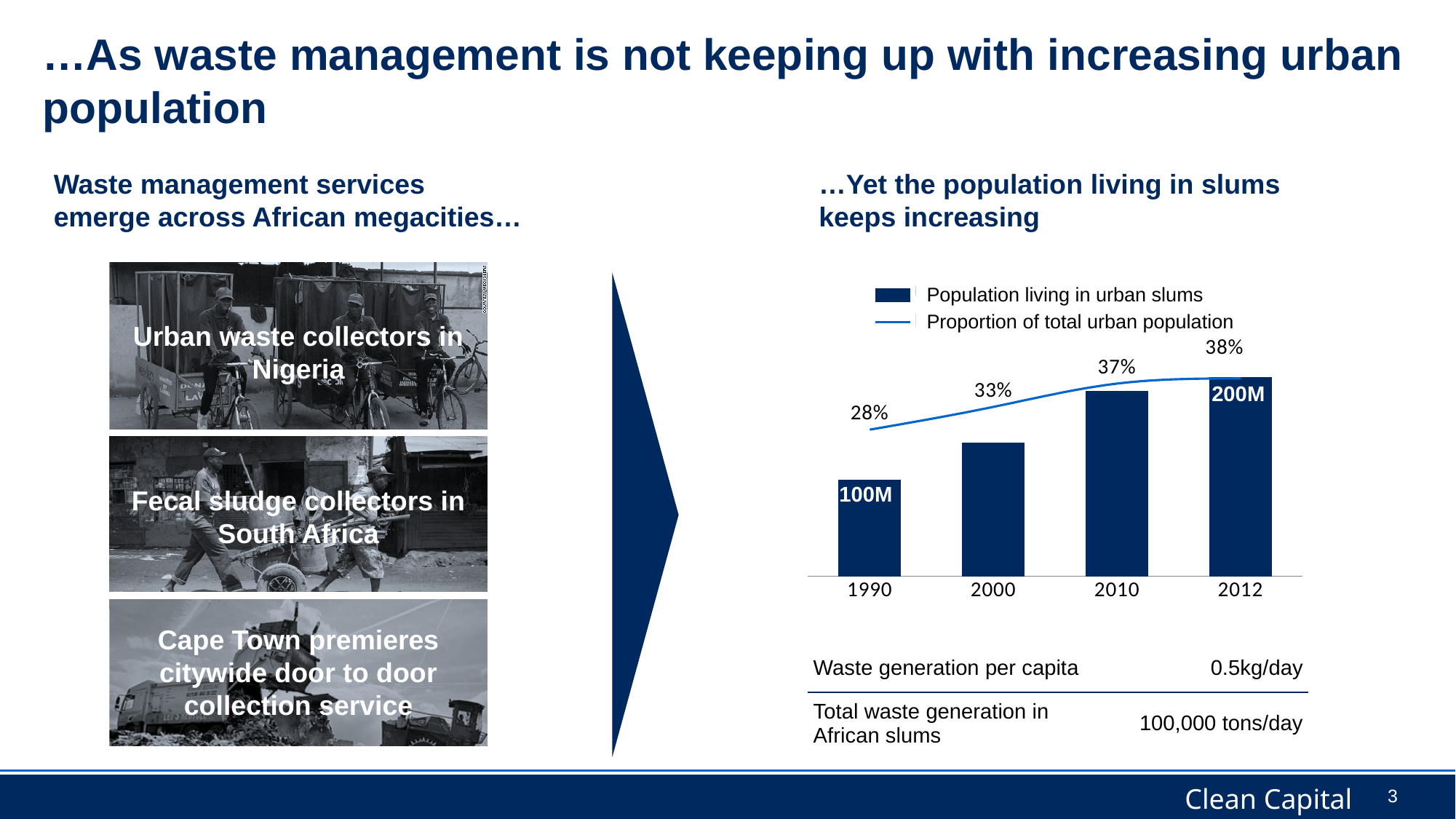
Which year has the highest population living in urban slums? 2012 Which year has a larger proportion of total urban population living in slums, 2000 or 2010? 2010 What is the population living in urban slums in 2012? 200M By how many percentage points did the proportion of total urban population living in slums rise from 1990 to 2012? 10 percentage points What is the population living in urban slums in 1990? 100M How many years are shown on the x axis of the chart? 4 By how much did the population living in urban slums grow from 1990 to 2012? 100M What proportion of the total urban population lived in slums in 2010? 37% Which year has the lowest proportion of total urban population living in slums? 1990 What proportion of the total urban population lived in slums in 2000? 33% How many series does the chart legend list? 2 Does the population living in urban slums rise or fall from 1990 to 2012? Rise